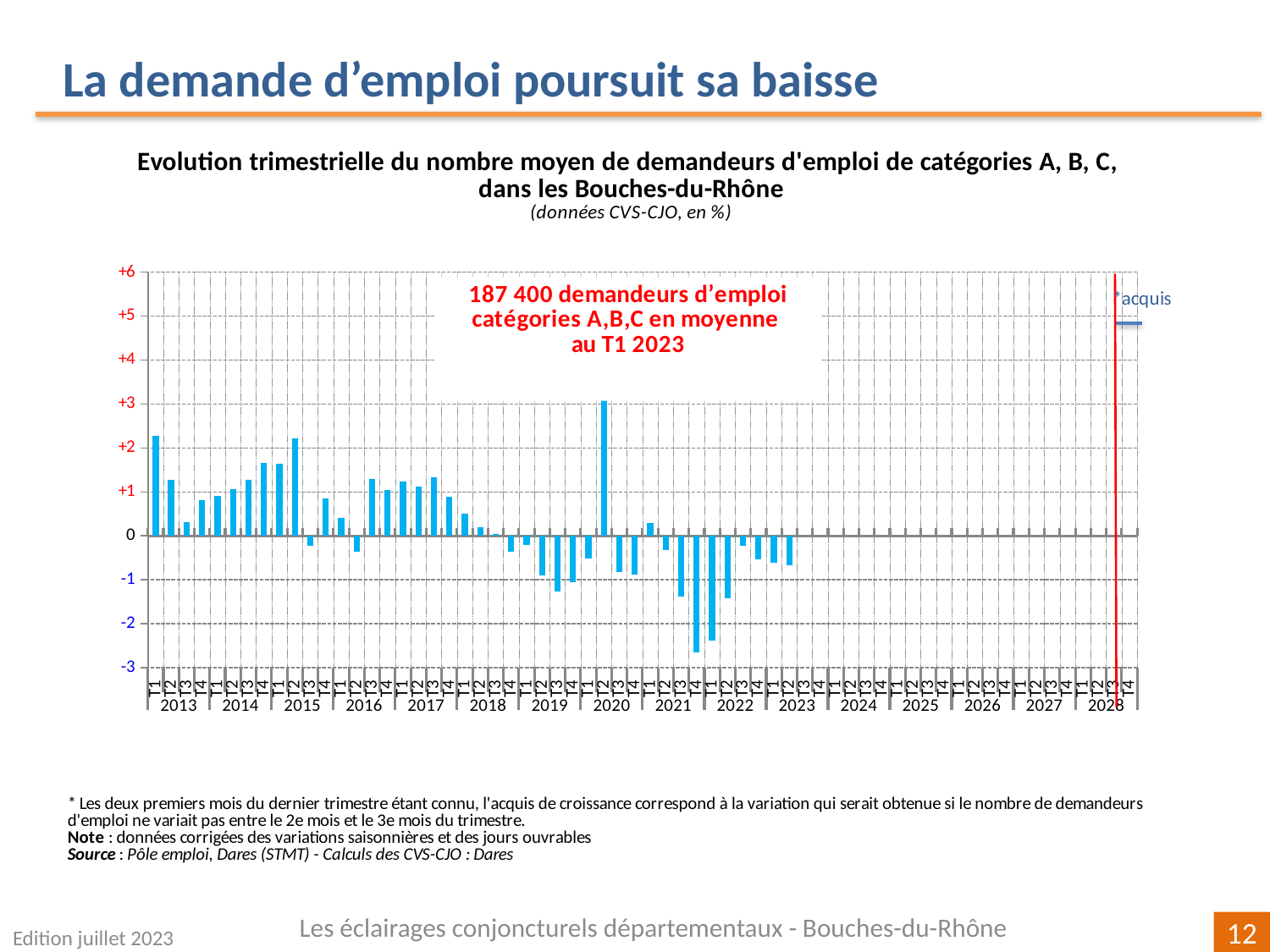
According to the annotation on the chart, how many demandeurs d'emploi catégories A,B,C were there on average in T1 2023? 187 400 Which quarter has the highest value on the chart? T2 2020 What kind of chart is shown on the slide? bar chart Which quarter has the lowest value on the chart? T4 2021 Is the value for T1 2022 greater or less than -2? less Is the value for T2 2020 greater or less than +2? greater How many years are labelled along the x axis of the chart? 16 Which is larger, the value for T4 2021 or the value for T3 2021? T3 2021 Is the value for T1 2013 greater or less than +2? greater Which is larger, the value for T2 2020 or the value for T1 2013? T2 2020